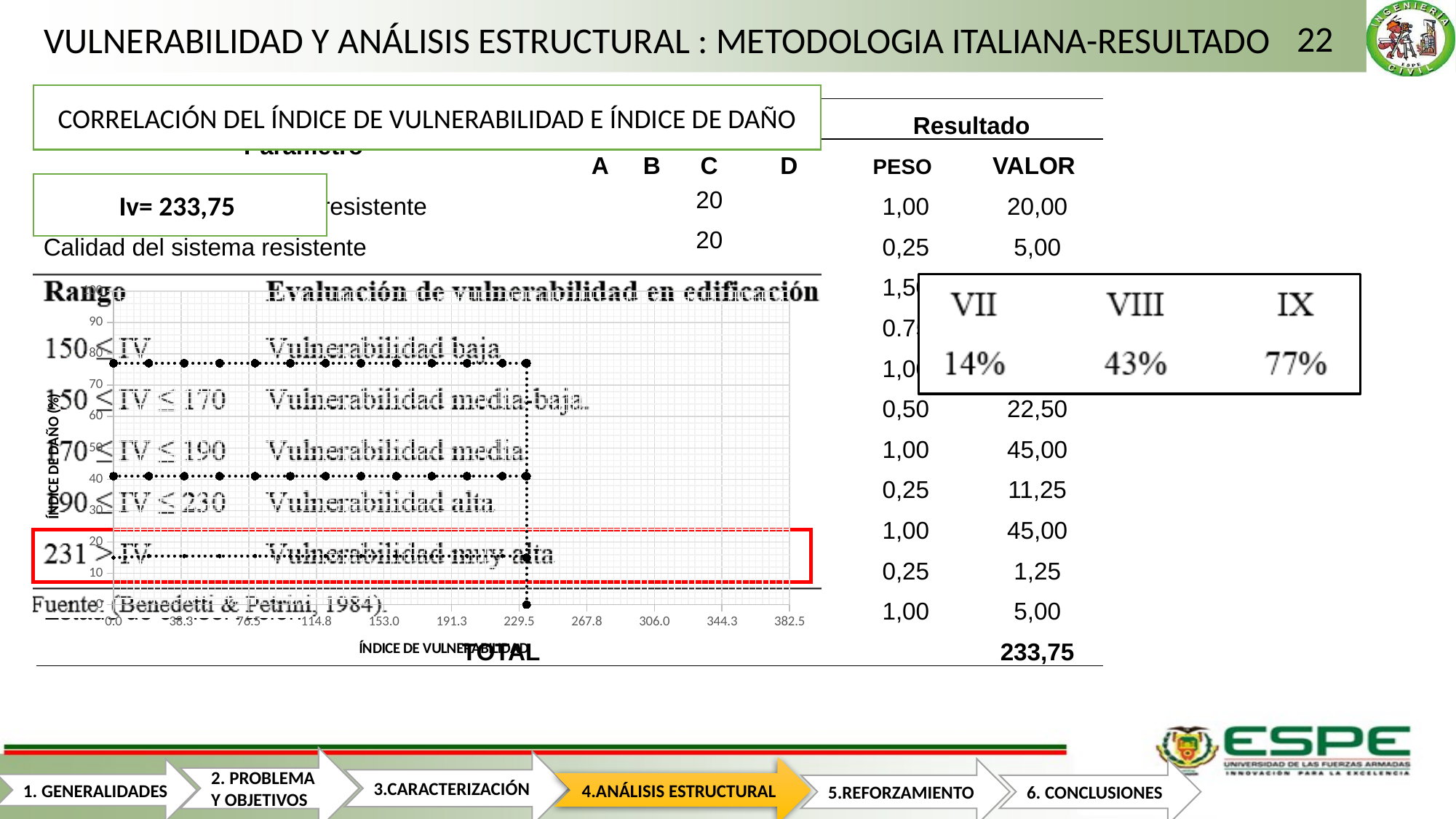
Is the value of the topmost horizontal dotted line greater or less than 60 on the y axis? greater Is the vertical dotted line positioned at an x value greater or less than 191.3? greater Is the value of the middle horizontal dotted line greater or less than 50 on the y axis? less What kind of chart is shown on the slide? line chart What is the title of the x axis of the chart? ÍNDICE DE VULNERABILIDAD How many horizontal dotted lines are plotted on the chart? 3 Which of the three horizontal dotted lines has the highest y value: the top, middle or bottom one? the top one What is the title of the y axis of the chart? ÍNDICE DE DAÑO (%)